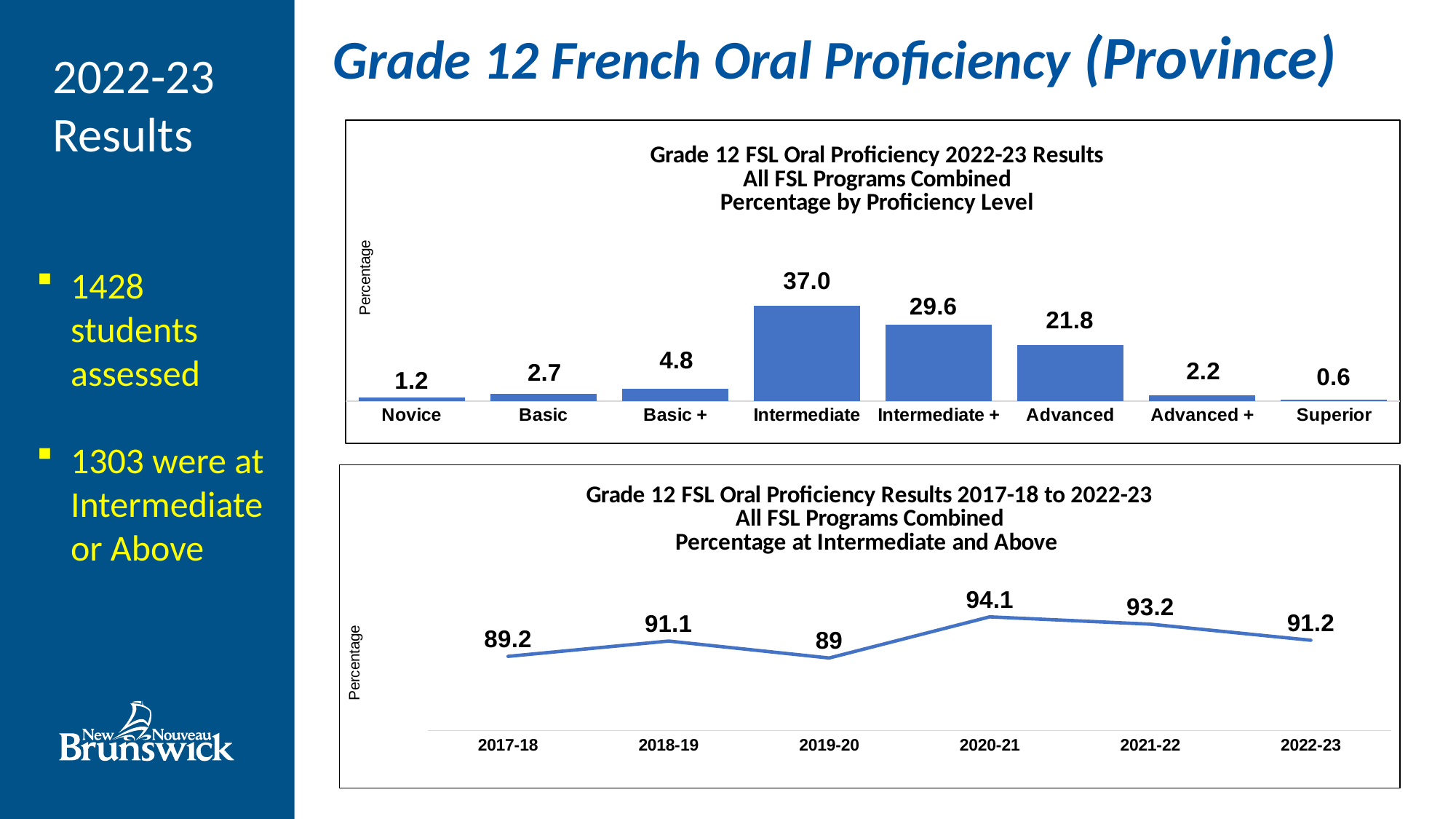
In the top chart (Grade 12 FSL Oral Proficiency 2022-23 Results), which proficiency level has the lowest percentage? Superior In the top chart (Grade 12 FSL Oral Proficiency 2022-23 Results), what is the difference between the Intermediate and Intermediate + values? 7.4 In the top chart (Grade 12 FSL Oral Proficiency 2022-23 Results), how many proficiency levels are shown? 8 In the top chart (Grade 12 FSL Oral Proficiency 2022-23 Results), what is the value for Intermediate? 37.0 In the top chart (Grade 12 FSL Oral Proficiency 2022-23 Results), which is larger, Basic + or Advanced +? Basic + In the bottom chart (Grade 12 FSL Oral Proficiency Results 2017-18 to 2022-23), what is the value for 2020-21? 94.1 In the top chart (Grade 12 FSL Oral Proficiency 2022-23 Results), what is the value for Advanced? 21.8 What kind of chart is the bottom chart (Grade 12 FSL Oral Proficiency Results 2017-18 to 2022-23)? Line chart In the bottom chart (Grade 12 FSL Oral Proficiency Results 2017-18 to 2022-23), which year has the lowest value? 2019-20 What kind of chart is the top chart (Grade 12 FSL Oral Proficiency 2022-23 Results)? Bar chart In the bottom chart (Grade 12 FSL Oral Proficiency Results 2017-18 to 2022-23), what is the difference between the 2020-21 and 2022-23 values? 2.9 In the top chart (Grade 12 FSL Oral Proficiency 2022-23 Results), which proficiency level has the highest percentage? Intermediate